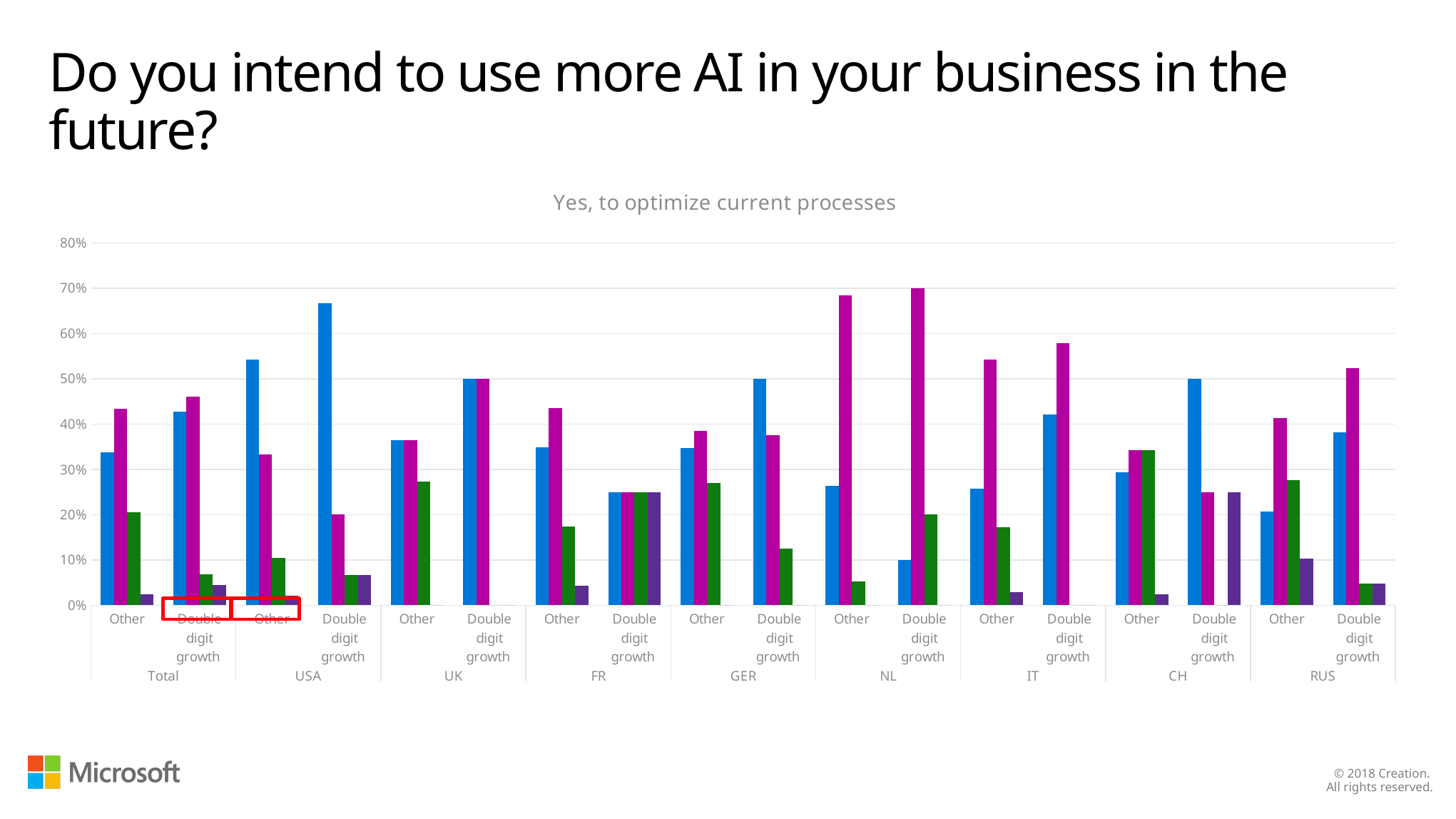
How many country/region groups are shown along the x axis of the chart? 9 Is the value of the magenta bar for NL Other greater or less than 60%? greater Is the value of the magenta bar for IT Double digit growth greater or less than 50%? greater Is the value of the green bar for UK Other greater or less than 20%? greater How many differently coloured bar series are plotted in the chart? 4 For NL Other, which is larger: the blue bar or the magenta bar? the magenta bar For USA Double digit growth, which is larger: the blue bar or the magenta bar? the blue bar What kind of chart is shown on the slide? bar chart What is the title of the chart? Yes, to optimize current processes